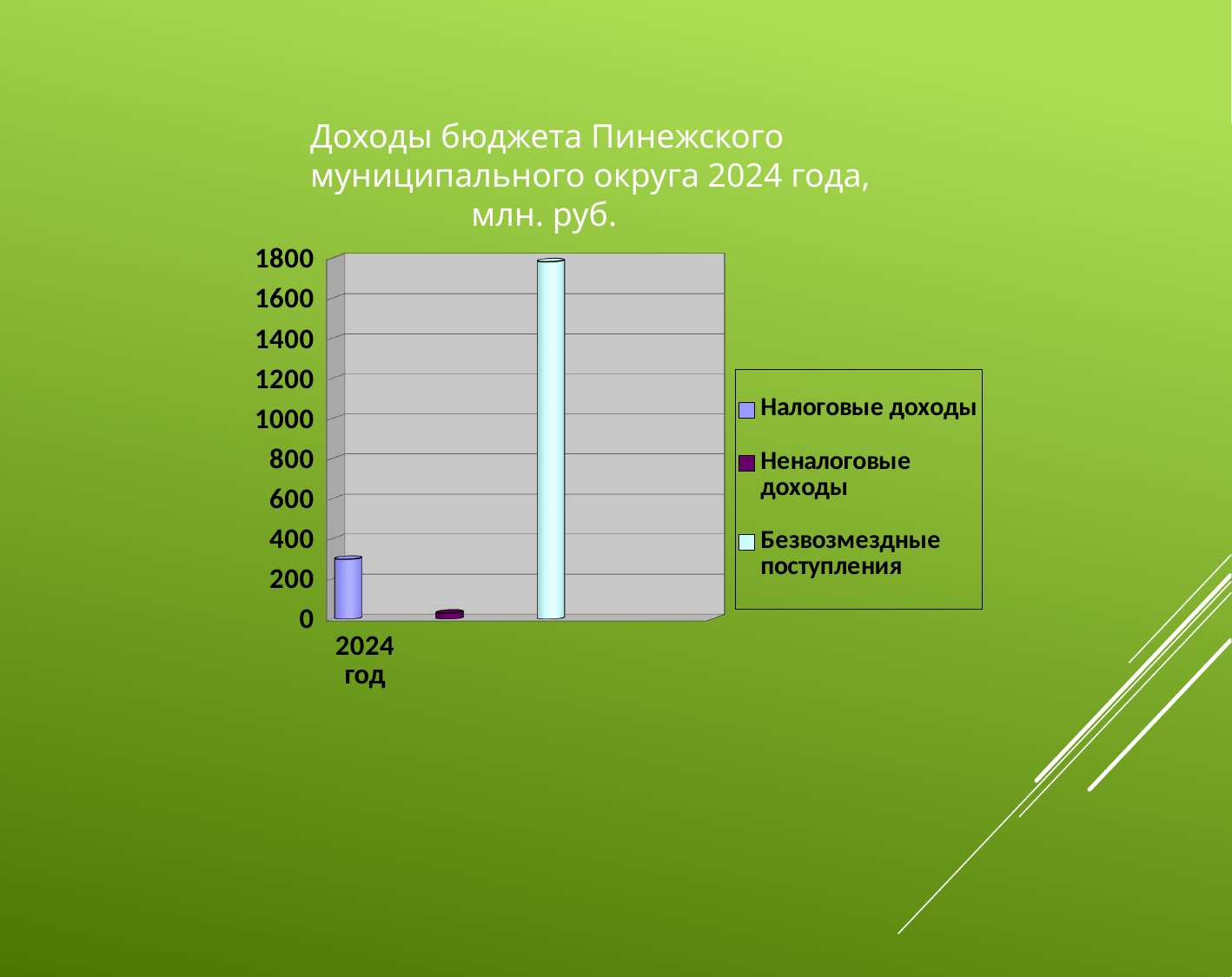
Which is larger for 2024 год: Налоговые доходы or Неналоговые доходы? Налоговые доходы Which is larger for 2024 год: Безвозмездные поступления or Налоговые доходы? Безвозмездные поступления What is the label of the category on the x axis? 2024 год Which series has the highest value for 2024 год? Безвозмездные поступления How many series does the legend list? 3 How many categories are shown on the x axis? 1 Is the value for Налоговые доходы greater or less than 400? less Is the value for Безвозмездные поступления greater or less than 1600? greater Is the value for Неналоговые доходы greater or less than 200? less What is the title of the chart? Доходы бюджета Пинежского муниципального округа 2024 года, млн. руб. What kind of chart is shown on the slide? bar chart Which series has the lowest value for 2024 год? Неналоговые доходы